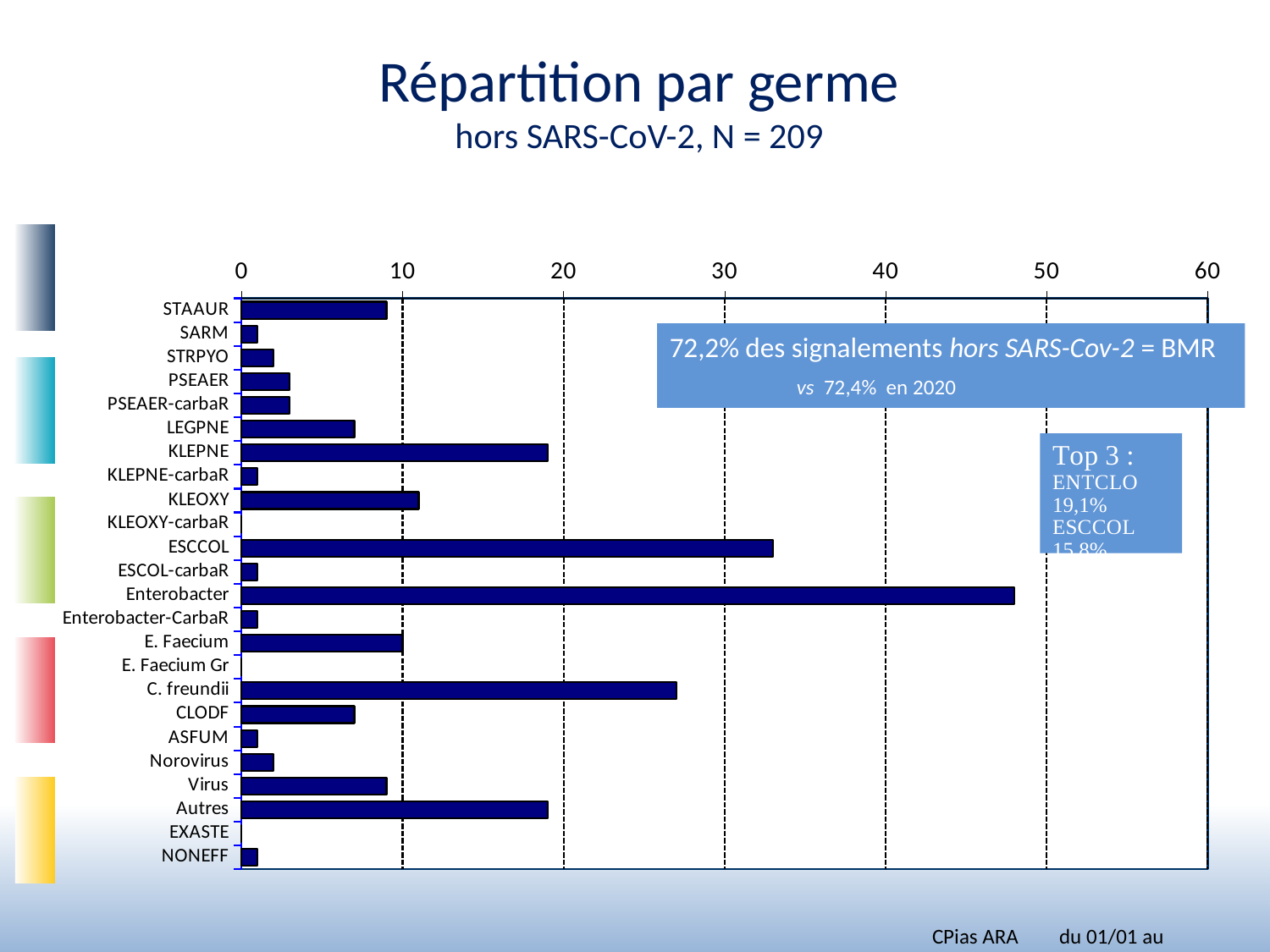
Which has the larger value, Enterobacter or ESCCOL? Enterobacter How many categories are listed on the vertical axis of the chart? 24 Is the value for C. freundii greater or less than 20? greater Is the value for ESCCOL greater or less than 30? greater What is the title of the slide containing the chart? Répartition par germe Is the value for CLODF greater or less than 10? less Which has the larger value, ESCCOL or C. freundii? ESCCOL Which has the larger value, KLEPNE or KLEOXY? KLEPNE Which category has the longest bar in the chart? Enterobacter What kind of chart is shown on the slide? bar chart